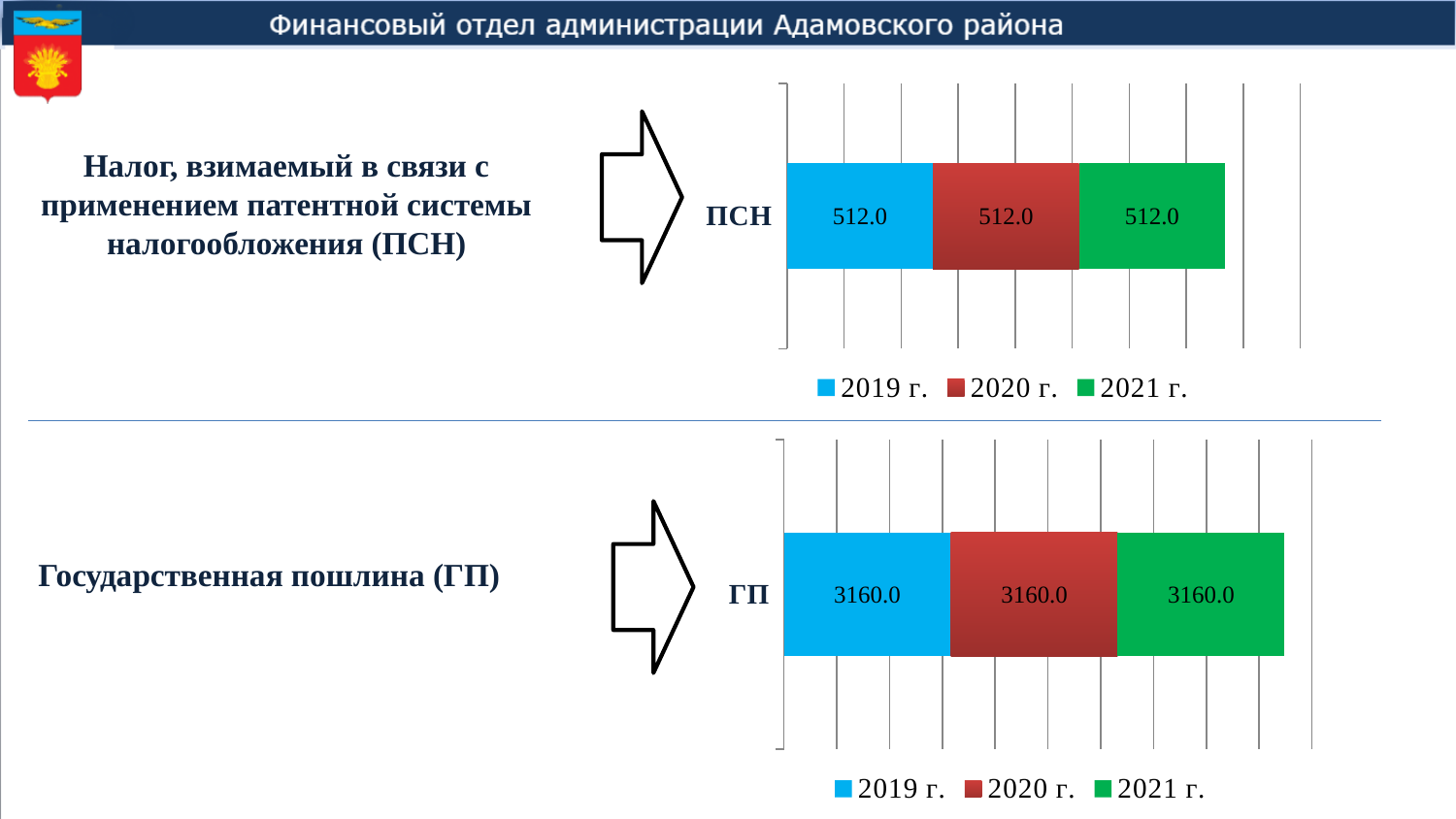
In the top chart (ПСН), what is the value for 2021 г.? 512.0 In the top chart (ПСН), what is the value for 2019 г.? 512.0 What kind of chart is the bottom chart (ГП)? Stacked bar chart In the top chart (ПСН), which colour represents 2020 г. in the legend? Red In the top chart (ПСН), what is the total of the stacked bar across all three years? 1536.0 In the bottom chart (ГП), what is the difference between the 2021 г. and 2019 г. values? 0.0 How many series does the legend of the top chart (ПСН) list? 3 In the bottom chart (ГП), do the values rise, fall or stay the same from 2019 г. to 2021 г.? Stay the same In the bottom chart (ГП), what is the value for 2021 г.? 3160.0 In the bottom chart (ГП), what is the total of the stacked bar across all three years? 9480.0 In the top chart (ПСН), what is the difference between the 2020 г. and 2019 г. values? 0.0 In the bottom chart (ГП), what is the value for 2020 г.? 3160.0